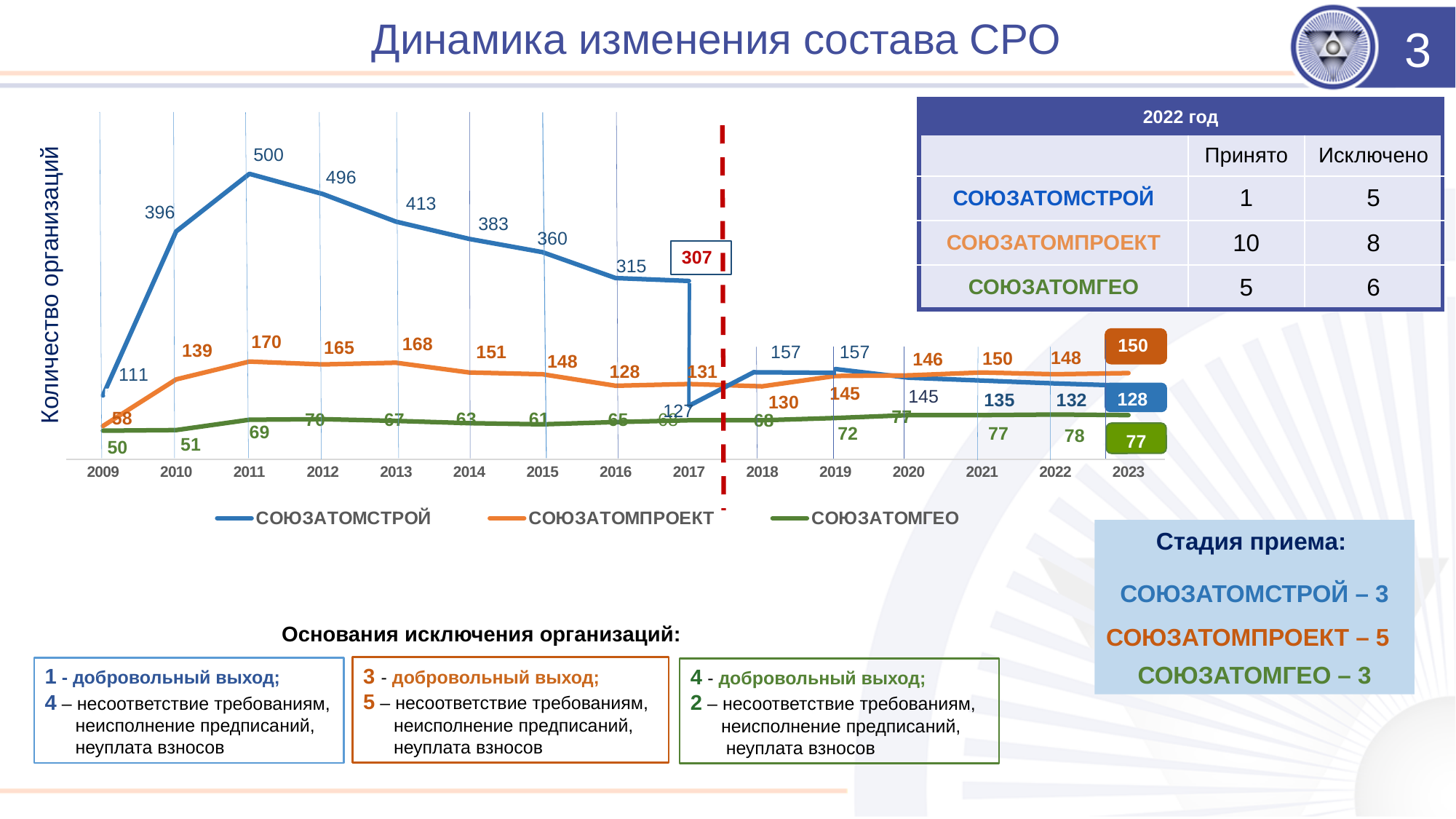
Does the СОЮЗАТОМСТРОЙ series rise or fall from 2011 to 2017? fall What is the value for СОЮЗАТОМПРОЕКТ in 2013? 168 In which year does СОЮЗАТОМСТРОЙ reach its highest value? 2011 In which year does СОЮЗАТОМГЕО have its lowest value? 2009 What is the value for СОЮЗАТОМГЕО in 2023? 77 What is the value for СОЮЗАТОМСТРОЙ in 2011? 500 How many years are shown on the x axis of the chart? 15 What is the difference between the СОЮЗАТОМСТРОЙ values in 2011 and 2012? 4 What kind of chart is shown on the slide? line chart Which colour is used for the СОЮЗАТОМГЕО series in the chart? green Which series has the larger value in 2023, СОЮЗАТОМПРОЕКТ or СОЮЗАТОМСТРОЙ? СОЮЗАТОМПРОЕКТ How many series does the chart legend list? 3